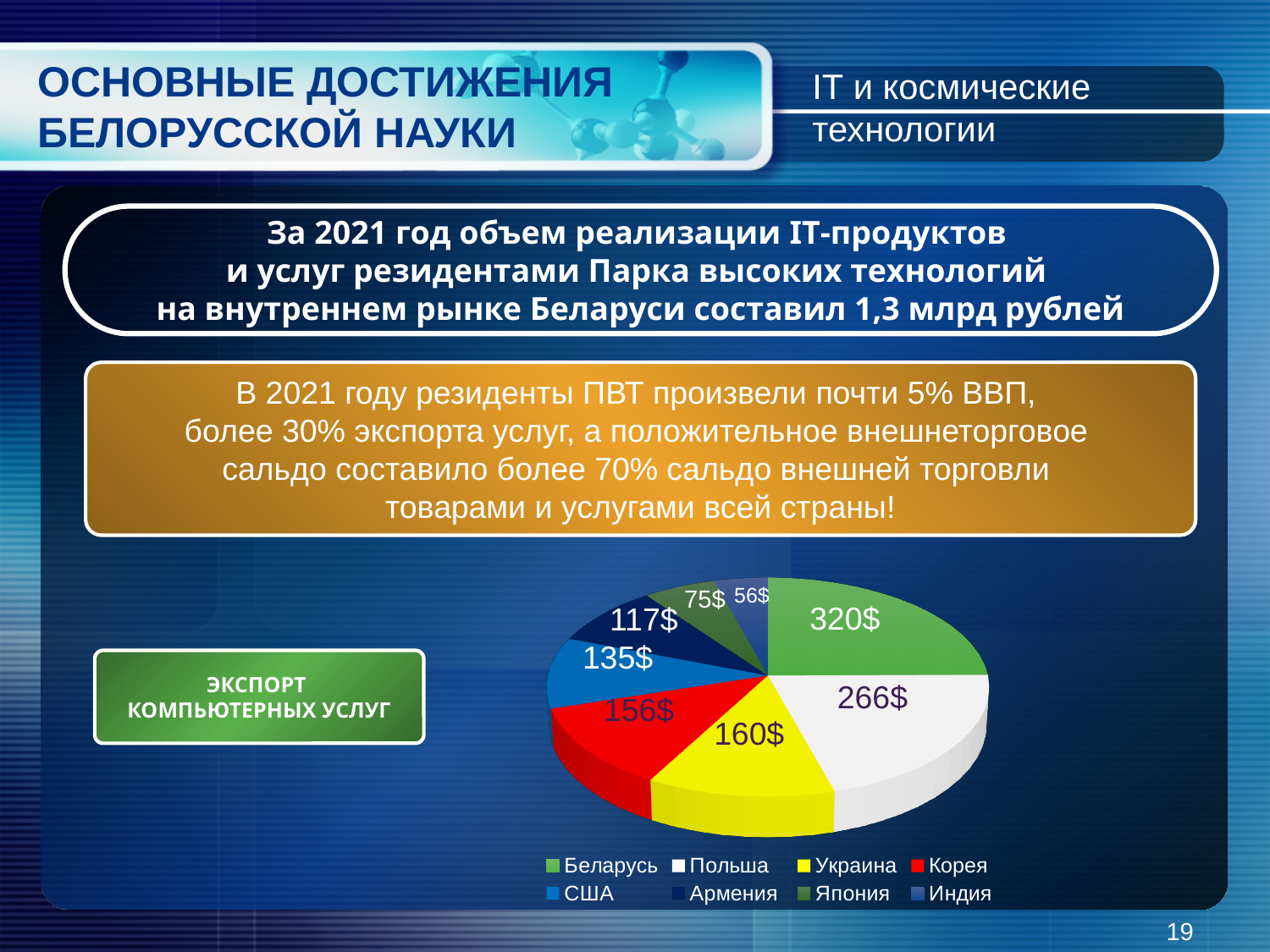
Which is larger, the value for Украина or the value for США? Украина What is the value for Беларусь in the pie chart? 320$ What is the difference between the values for Беларусь and Польша? 54$ What is the value for США in the pie chart? 135$ How many countries are shown in the pie chart? 8 Which country has the smallest slice in the pie chart? Индия What kind of chart is shown on the slide? pie chart Which country has the largest slice in the pie chart? Беларусь What is the value for Польша in the pie chart? 266$ What colour is the slice for Корея in the pie chart? red What is the difference between the values for Армения and Япония? 42$ What is the value for Индия in the pie chart? 56$